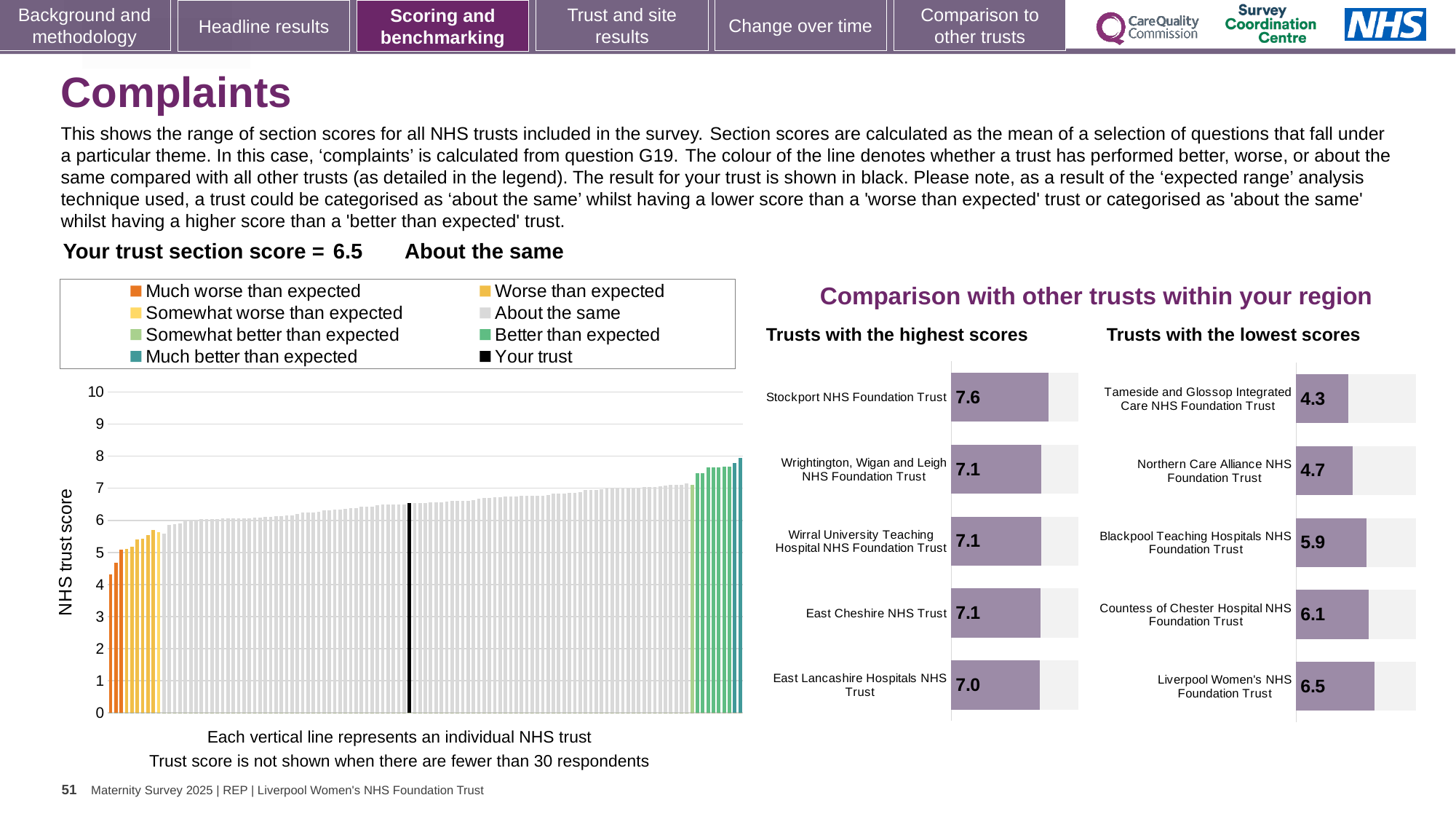
How many trusts are listed in the 'Trusts with the highest scores' chart? 5 In the 'Trusts with the lowest scores' chart, what is the difference between the scores of Liverpool Women's NHS Foundation Trust and Tameside and Glossop Integrated Care NHS Foundation Trust? 2.2 What kind of chart is the large 'NHS trust score' chart on the left of the slide? Bar chart In the 'Trusts with the highest scores' chart, what is the score for Stockport NHS Foundation Trust? 7.6 In the 'Trusts with the lowest scores' chart, what is the score for Liverpool Women's NHS Foundation Trust? 6.5 In the 'Trusts with the highest scores' chart, which trust has the highest score? Stockport NHS Foundation Trust In the 'Trusts with the highest scores' chart, what is the difference between the scores of Stockport NHS Foundation Trust and East Lancashire Hospitals NHS Trust? 0.6 In the 'Trusts with the lowest scores' chart, what is the score for Tameside and Glossop Integrated Care NHS Foundation Trust? 4.3 In the large 'NHS trust score' chart on the left, is the value of the lowest bar greater or less than 5? less How many entries does the legend above the large 'NHS trust score' chart list? 8 In the 'Trusts with the lowest scores' chart, which has the larger score: Blackpool Teaching Hospitals NHS Foundation Trust or Northern Care Alliance NHS Foundation Trust? Blackpool Teaching Hospitals NHS Foundation Trust In the 'Trusts with the lowest scores' chart, which trust has the lowest score? Tameside and Glossop Integrated Care NHS Foundation Trust